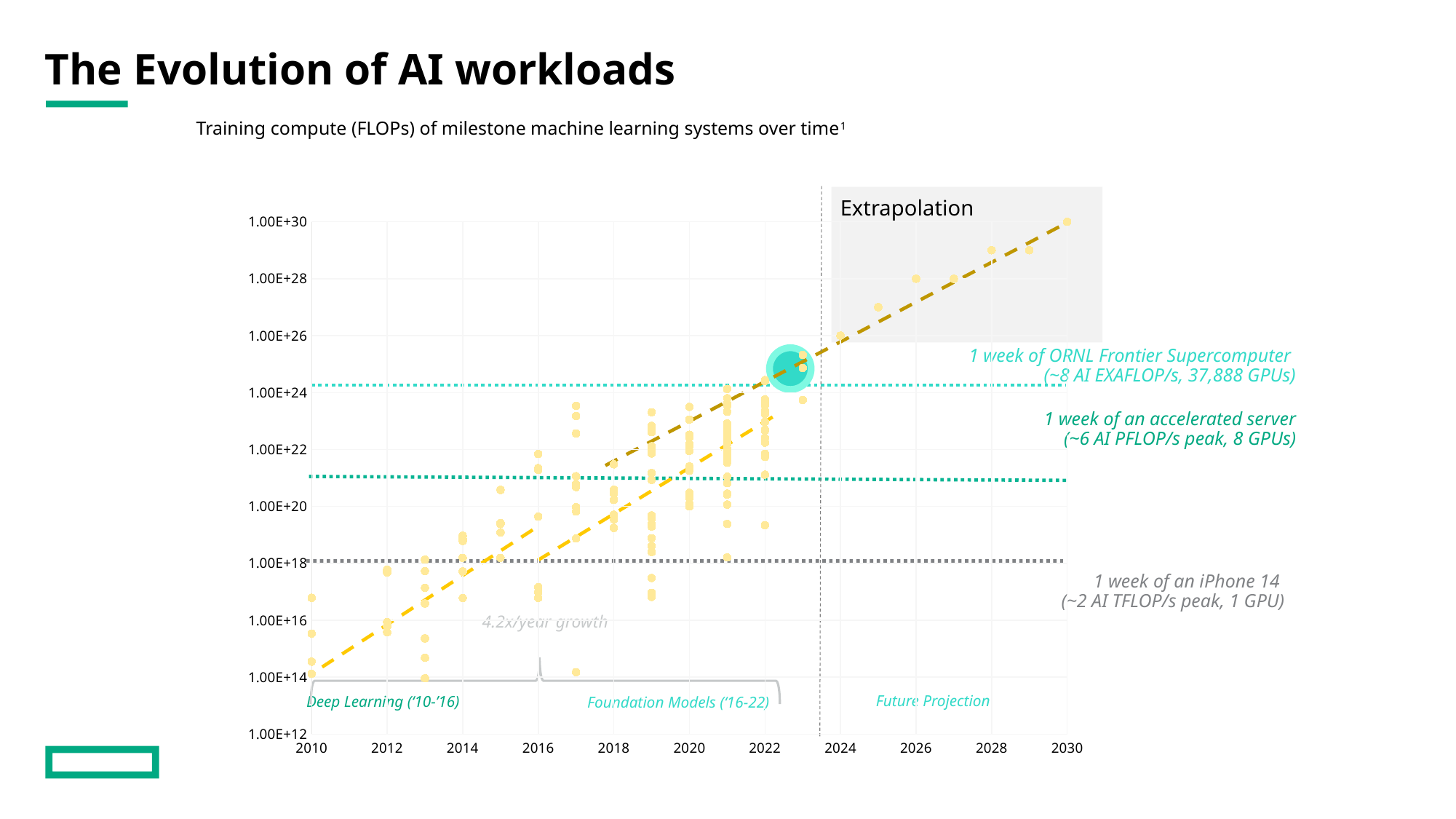
How many year labels are shown on the x axis? 11 Is the dotted line for '1 week of an accelerated server' greater or less than 1.00E+22? less In which year does the highest plotted point appear? 2030 Is the highest plotted point in 2017 greater or less than 1.00E+22? greater Do the plotted training compute values rise or fall as the years increase along the x axis? rise Is the dotted line for '1 week of ORNL Frontier Supercomputer' greater or less than 1.00E+24? greater What kind of chart is shown on the slide? scatter chart Which is higher, the plotted point at 2030 or the plotted point at 2024? 2030 What yearly growth rate is annotated on the chart? 4.2x/year growth